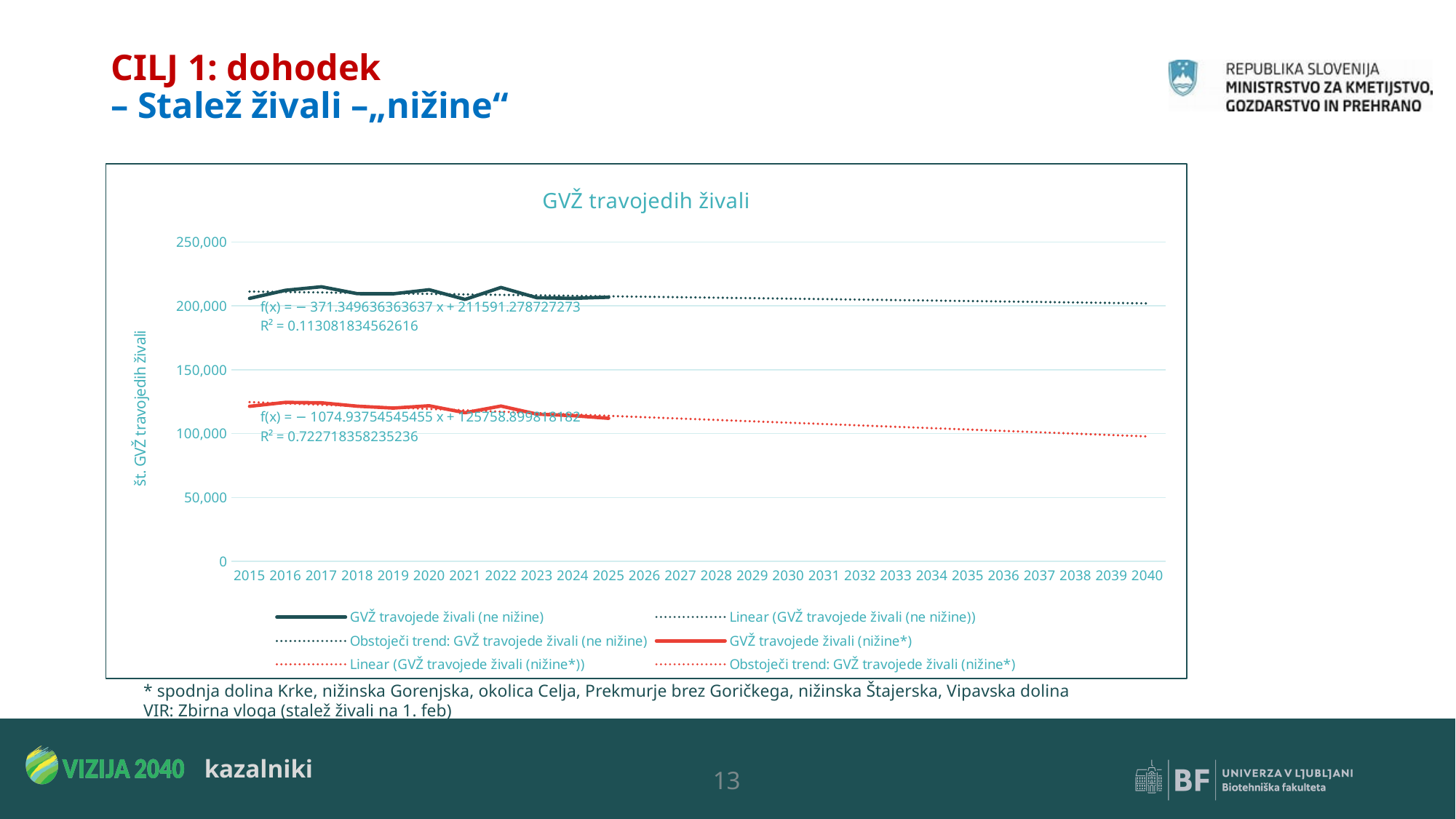
What is the R² value printed for the trend line of the nižine* series? 0.722718358235236 What is the title of the chart? GVŽ travojedih živali Is the value for GVŽ travojede živali (nižine*) in 2025 greater or less than 150,000? less How many years are labelled on the x axis of the chart? 26 Is the value for GVŽ travojede živali (ne nižine) in 2017 greater or less than 200,000? greater Is the value for GVŽ travojede živali (ne nižine) in 2025 greater or less than 250,000? less What kind of chart is shown on the slide? line chart What is the last year shown on the x axis of the chart? 2040 How many entries does the chart legend list? 6 Which series has the larger value in 2020, GVŽ travojede živali (ne nižine) or GVŽ travojede živali (nižine*)? GVŽ travojede živali (ne nižine) Does the GVŽ travojede živali (nižine*) series rise or fall from 2015 to 2025? fall